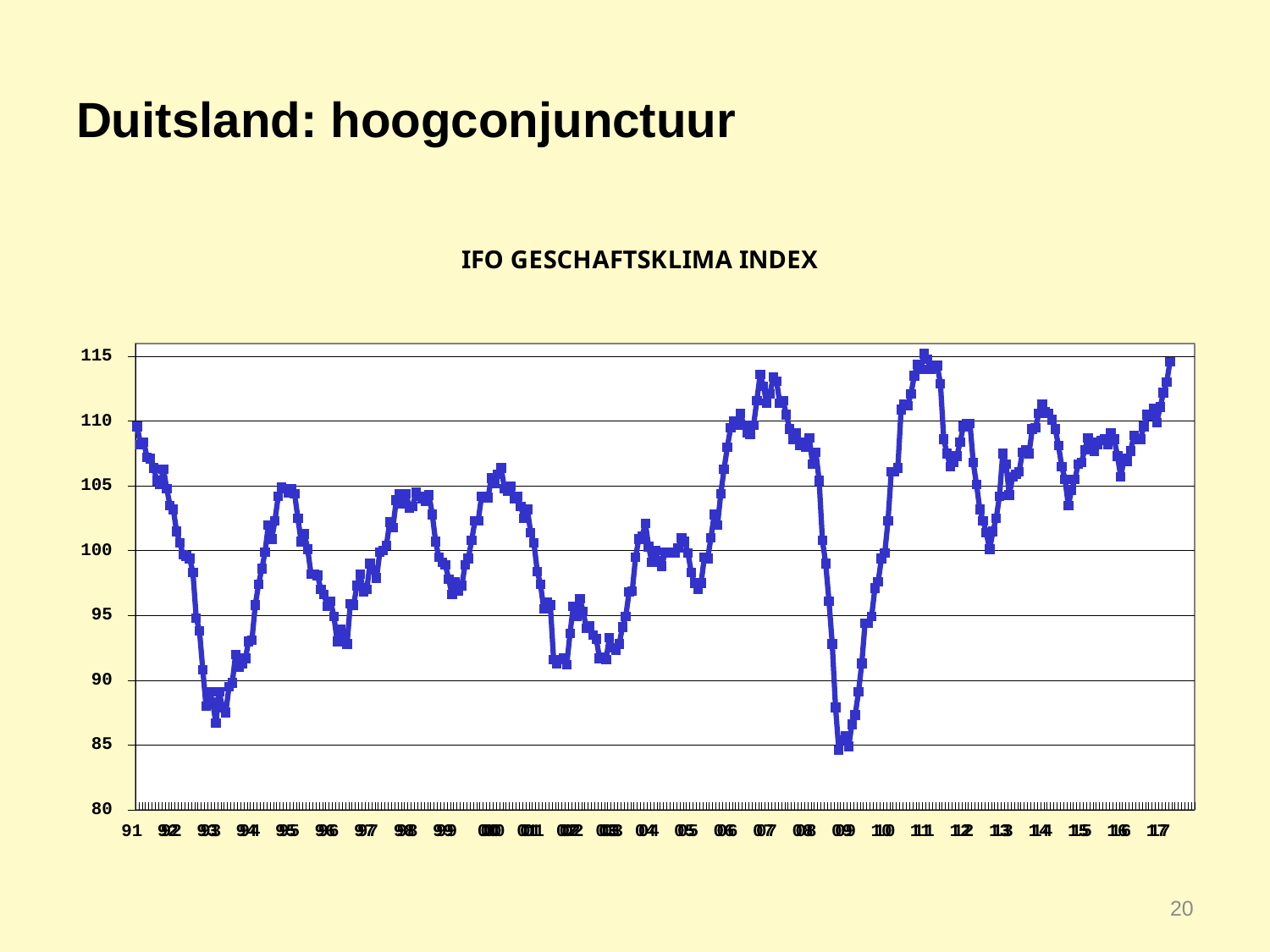
Does the index rise or fall between 09 and 11? rise What kind of chart is shown on the slide? line chart How many data series are plotted on the chart? 1 Does the index rise or fall between 91 and 93? fall What colour is the plotted line? blue Around which year label does the index reach its lowest point? 09 Is the value of the index at the end of 17 greater or less than 110? greater Is the lowest value of the index around 09 greater or less than 90? less Is the lowest value of the index around 93 greater or less than 90? less What is the title of the chart? IFO GESCHAFTSKLIMA INDEX